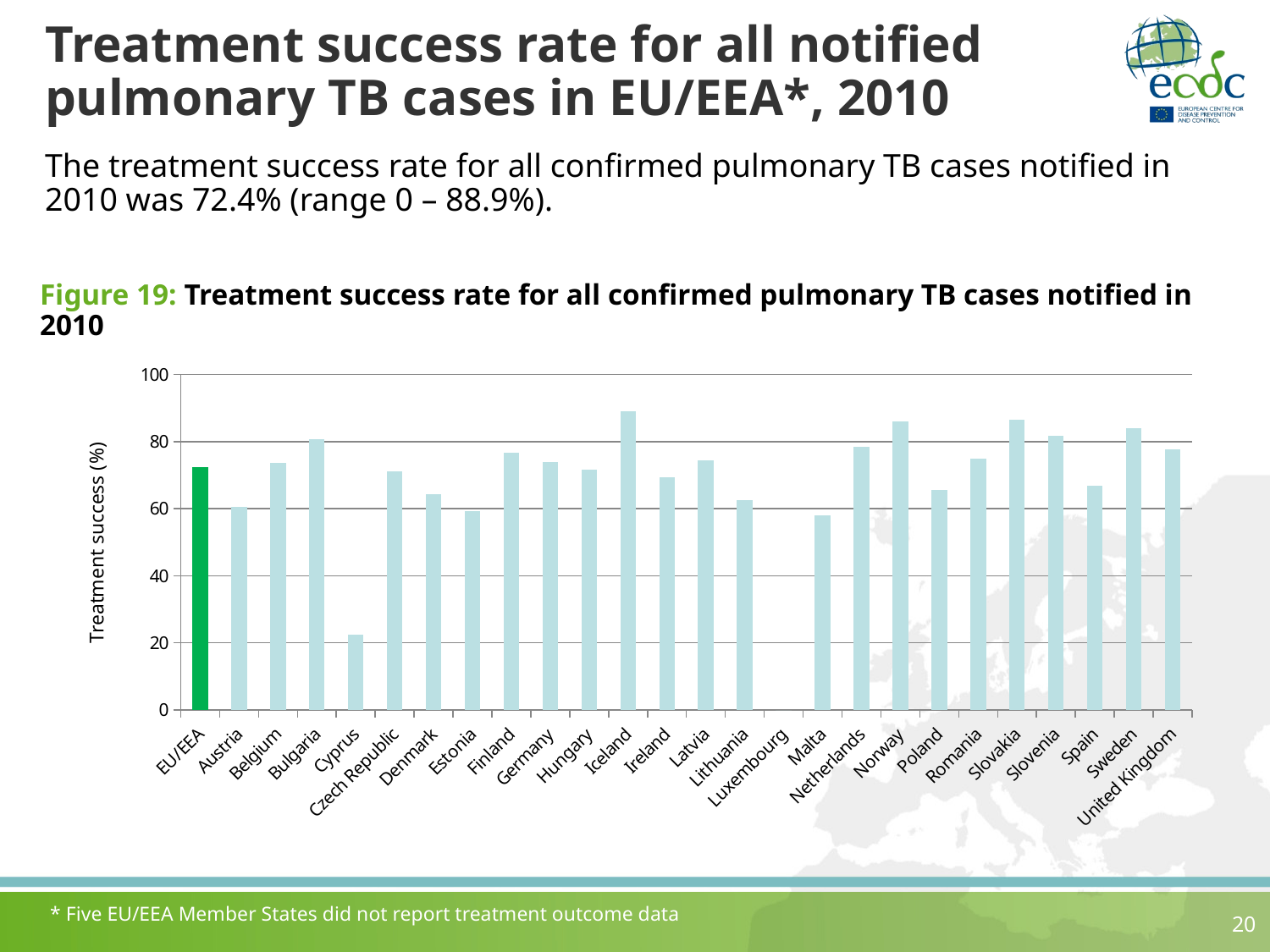
How many categories are shown on the x axis of the chart? 26 Which country has no bar shown in the chart? Luxembourg Which country has the lowest visible bar in the chart? Cyprus What kind of chart is shown in Figure 19? bar chart Which country has the highest treatment success rate in the chart? Iceland Is the treatment success rate for Malta greater or less than 60? less Is the treatment success rate for Iceland greater or less than 80? greater Is the treatment success rate for Sweden greater or less than 80? greater Which has a higher treatment success rate, Norway or Poland? Norway Which has a higher treatment success rate, Slovakia or Malta? Slovakia What is the label on the y axis of the chart? Treatment success (%)